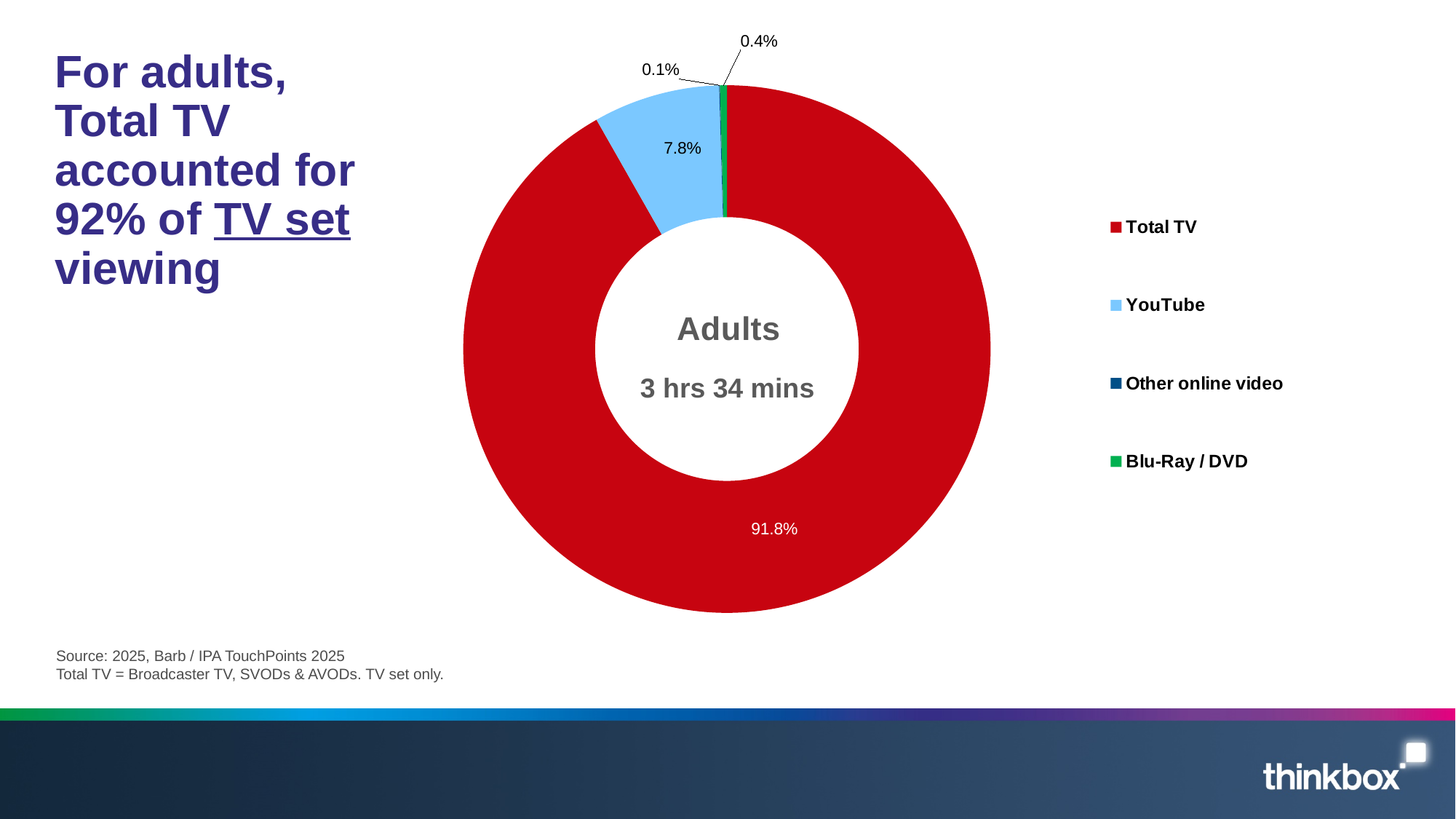
Which is larger, the YouTube slice or the Blu-Ray / DVD slice? YouTube What colour is the Total TV slice in the chart? Red What kind of chart is shown on the slide? Pie chart (donut) Which category has the smallest slice in the chart? Other online video What share of TV set viewing does YouTube account for in the chart? 7.8% What share does Other online video account for in the chart? 0.1% How many categories does the legend list? 4 What share does Blu-Ray / DVD account for in the chart? 0.4% What is the difference in percentage points between the Total TV and YouTube slices? 84.0 percentage points Which category has the largest slice in the chart? Total TV What share of TV set viewing does Total TV account for in the chart? 91.8% What text is shown in the centre of the donut chart? Adults, 3 hrs 34 mins